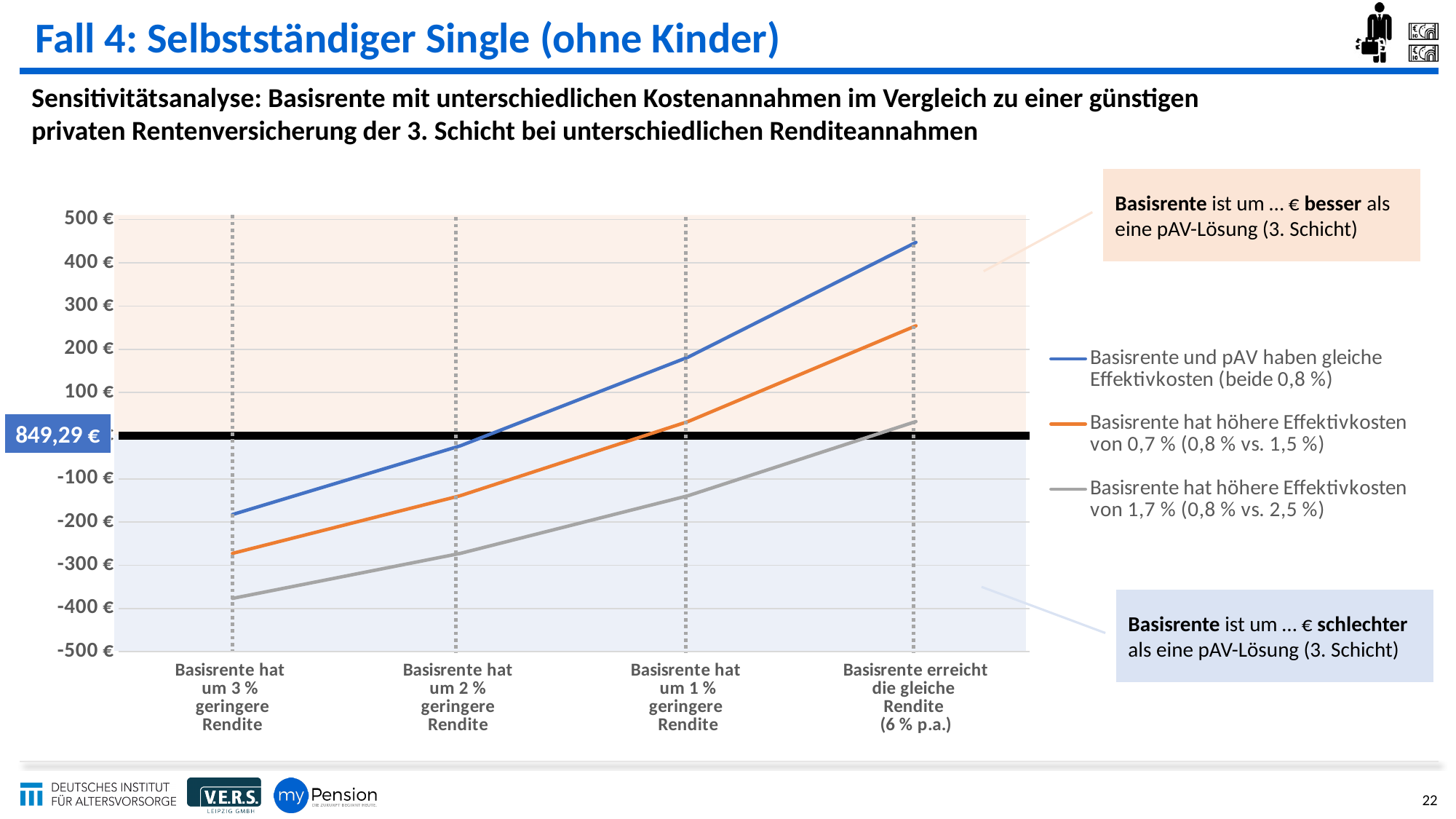
At 'Basisrente hat um 3 % geringere Rendite', which series has the higher value: 'Basisrente und pAV haben gleiche Effektivkosten (beide 0,8 %)' or 'Basisrente hat höhere Effektivkosten von 1,7 % (0,8 % vs. 2,5 %)'? Basisrente und pAV haben gleiche Effektivkosten (beide 0,8 %) What kind of chart is shown on the slide? line chart Is the value of the series 'Basisrente hat höhere Effektivkosten von 0,7 % (0,8 % vs. 1,5 %)' at 'Basisrente erreicht die gleiche Rendite (6 % p.a.)' greater or less than 200 €? greater Is the value of the series 'Basisrente hat höhere Effektivkosten von 1,7 % (0,8 % vs. 2,5 %)' at 'Basisrente hat um 3 % geringere Rendite' greater or less than -300 €? less Is the value of the series 'Basisrente und pAV haben gleiche Effektivkosten (beide 0,8 %)' at 'Basisrente hat um 1 % geringere Rendite' greater or less than 100 €? greater What value is labelled on the thick black horizontal reference line in the chart? 849,29 € How many series does the legend list? 3 For which x-axis category does the series 'Basisrente und pAV haben gleiche Effektivkosten (beide 0,8 %)' reach its highest value? Basisrente erreicht die gleiche Rendite (6 % p.a.) For which x-axis category does the series 'Basisrente hat höhere Effektivkosten von 1,7 % (0,8 % vs. 2,5 %)' reach its lowest value? Basisrente hat um 3 % geringere Rendite How many categories are shown on the x axis? 4 Do the values of the series 'Basisrente und pAV haben gleiche Effektivkosten (beide 0,8 %)' rise or fall from left to right along the x axis? rise